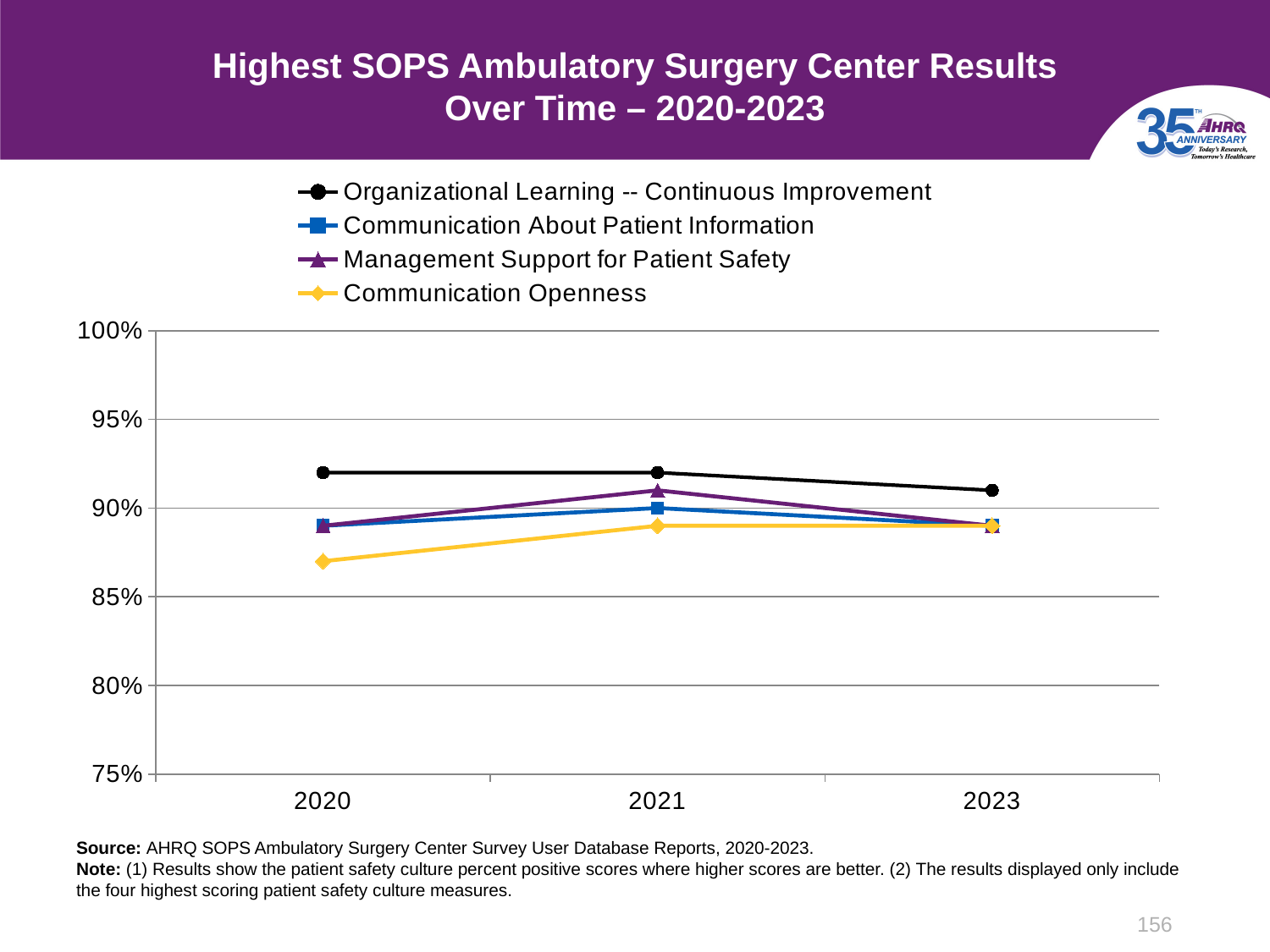
How many years are shown on the x axis? 3 Is the value for Communication Openness in 2020 greater or less than 85%? greater Which series has the highest value in 2021? Organizational Learning -- Continuous Improvement Which series is drawn in yellow? Communication Openness Is the value for Organizational Learning -- Continuous Improvement in 2020 greater or less than 90%? greater How many series does the legend list? 4 Is the value for Communication Openness in 2020 greater or less than 90%? less Which series has the highest value in 2020? Organizational Learning -- Continuous Improvement What kind of chart is shown on the slide? line chart Which series has the lowest value in 2020? Communication Openness Does the value for Communication Openness rise or fall from 2020 to 2021? rise Does the value for Organizational Learning -- Continuous Improvement rise or fall from 2021 to 2023? fall